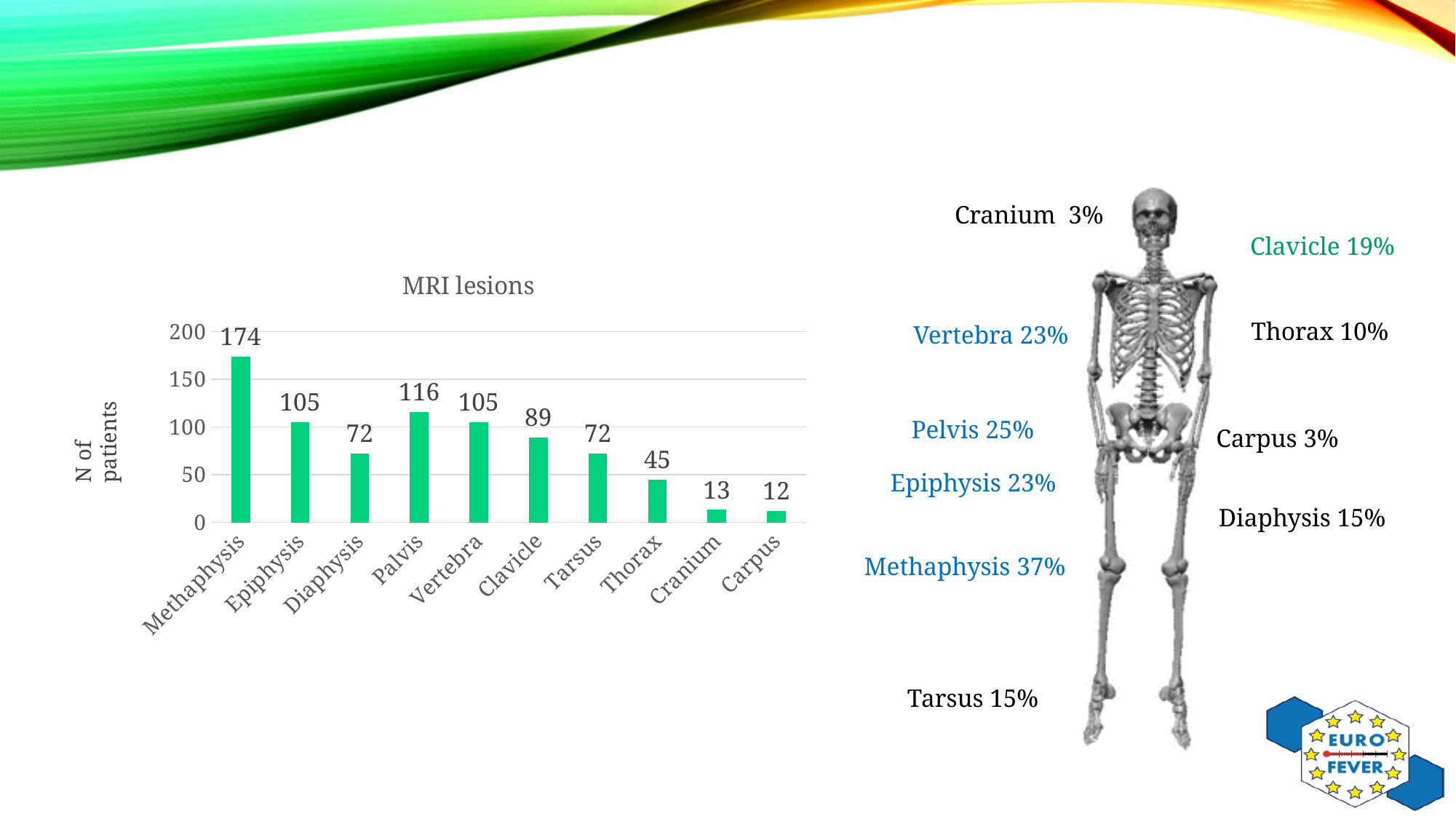
Which category has the highest number of patients? Methaphysis What is the number of patients for Methaphysis? 174 What is the title of the chart? MRI lesions What is the number of patients for Clavicle? 89 How many categories are shown on the x axis of the chart? 10 Which category has the lowest number of patients? Carpus What is the difference in number of patients between Cranium and Carpus? 1 What is the number of patients for Thorax? 45 What is the difference in number of patients between Methaphysis and Palvis? 58 What type of chart is shown on the slide? bar chart Which has more patients, Palvis or Vertebra? Palvis What is the label of the y axis? N of patients